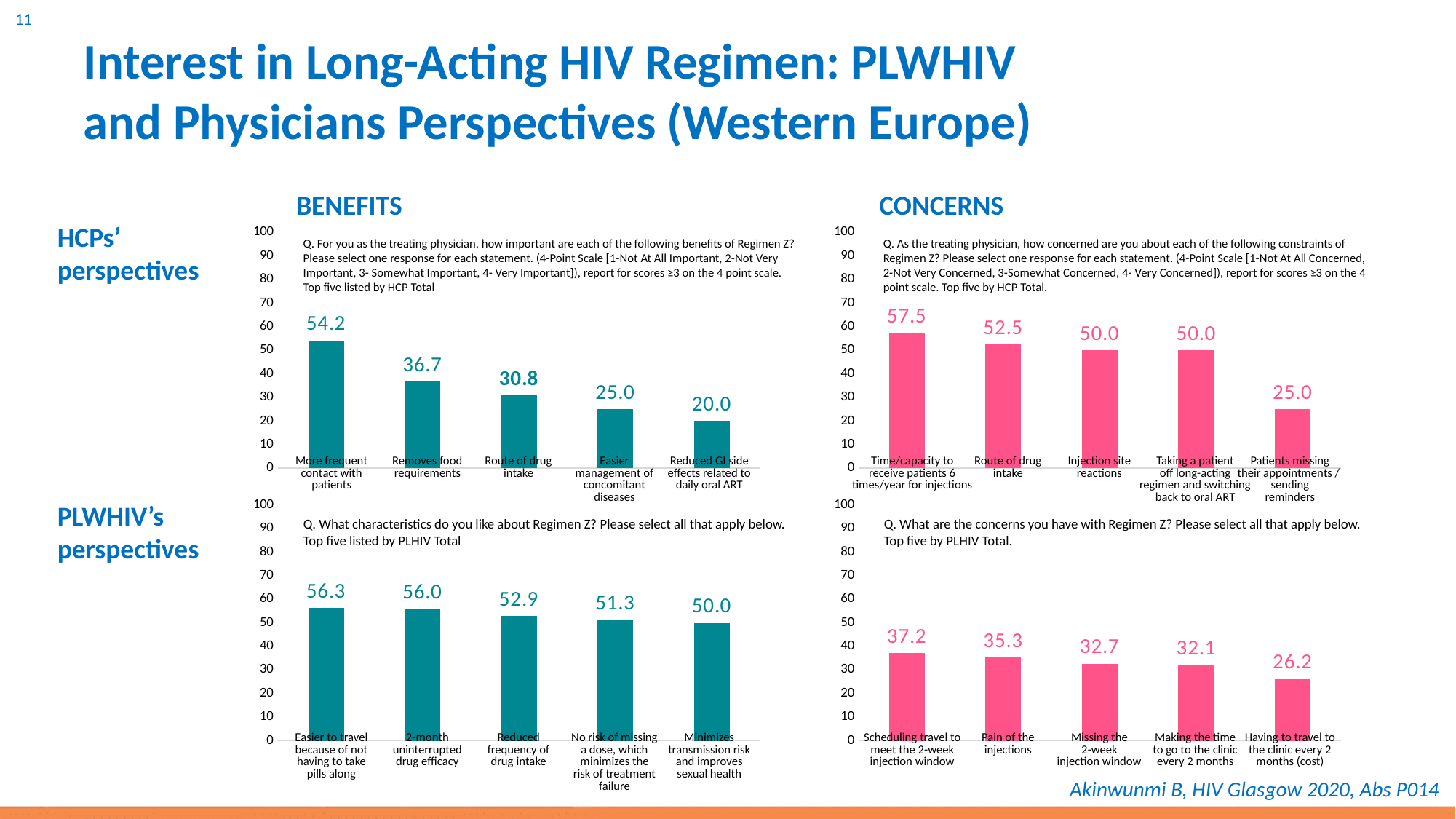
In the PLWHIV's perspectives Benefits chart (bottom left), what is the value for "2-month uninterrupted drug efficacy"? 56.0 In the HCPs' perspectives Benefits chart (top left), what is the value for "Route of drug intake"? 30.8 What type of chart is the HCPs' perspectives Benefits chart (top left)? bar chart In the HCPs' perspectives Benefits chart (top left), what is the difference between "More frequent contact with patients" and "Reduced GI side effects related to daily oral ART"? 34.2 In the HCPs' perspectives Benefits chart (top left), which category has the highest value? More frequent contact with patients In the HCPs' perspectives Concerns chart (top right), which category has the lowest value? Patients missing their appointments / sending reminders In the HCPs' perspectives Concerns chart (top right), how many categories are plotted? 5 In the PLWHIV's perspectives Concerns chart (bottom right), which is larger: "Scheduling travel to meet the 2-week injection window" or "Having to travel to the clinic every 2 months (cost)"? Scheduling travel to meet the 2-week injection window In the HCPs' perspectives Concerns chart (top right), what is the value for "Time/capacity to receive patients 6 times/year for injections"? 57.5 In the PLWHIV's perspectives Concerns chart (bottom right), what is the difference between "Missing the 2-week injection window" and "Making the time to go to the clinic every 2 months"? 0.6 In the PLWHIV's perspectives Concerns chart (bottom right), what is the value for "Pain of the injections"? 35.3 In the PLWHIV's perspectives Benefits chart (bottom left), do the values rise or fall from left to right? fall